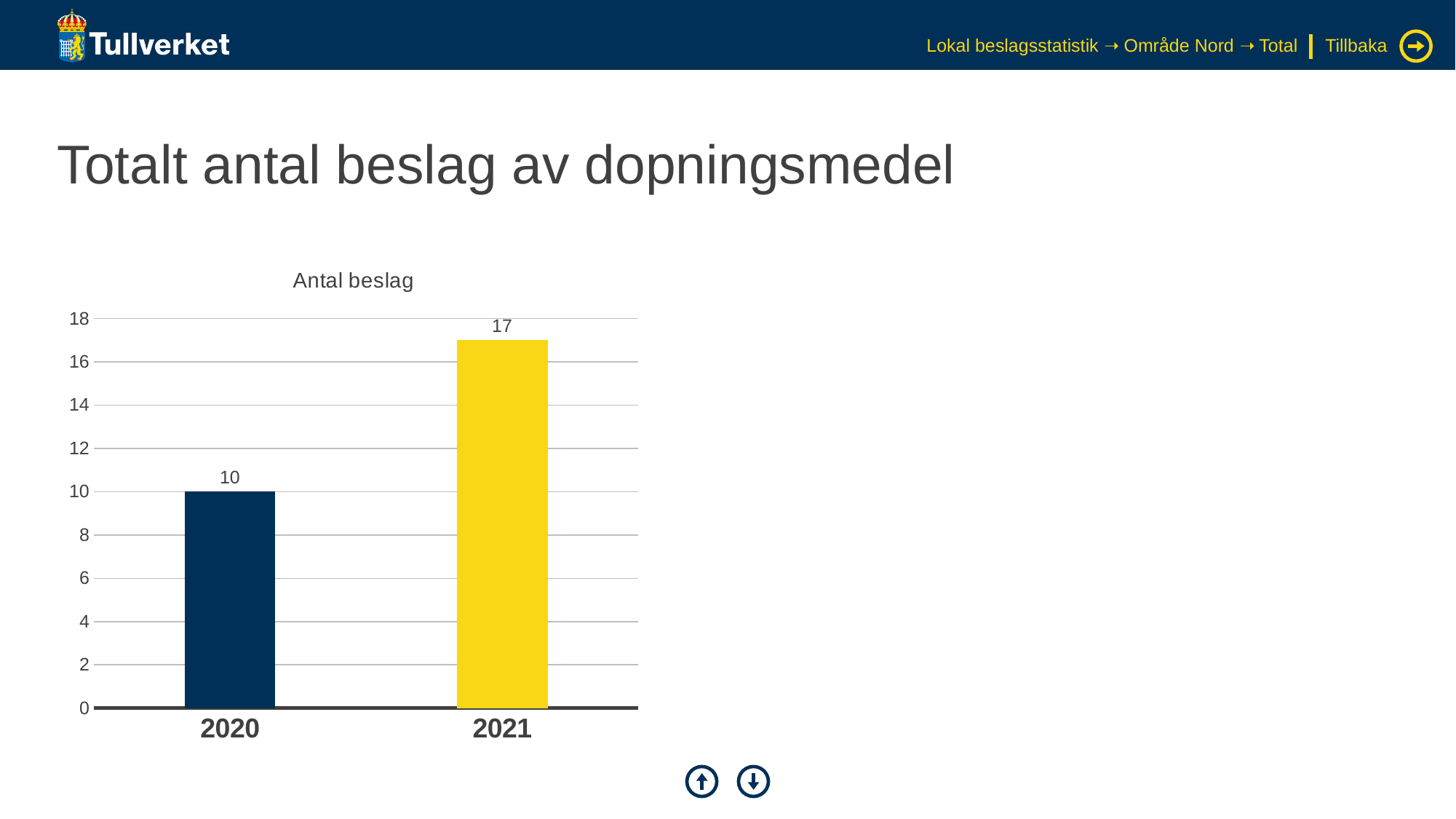
What is the value for 2020? 10 Which is larger, the value for 2020 or the value for 2021? 2021 What is the value for 2021? 17 Which year has the lowest number of seizures? 2020 Is the value for 2021 greater or less than 16? greater What is the title of the chart? Antal beslag Is the value for 2020 greater or less than 12? less How many years are shown on the x axis? 2 Do the values rise or fall from 2020 to 2021? rise Which year has the highest number of seizures? 2021 What kind of chart is shown on the slide? bar chart What is the difference between the values for 2021 and 2020? 7